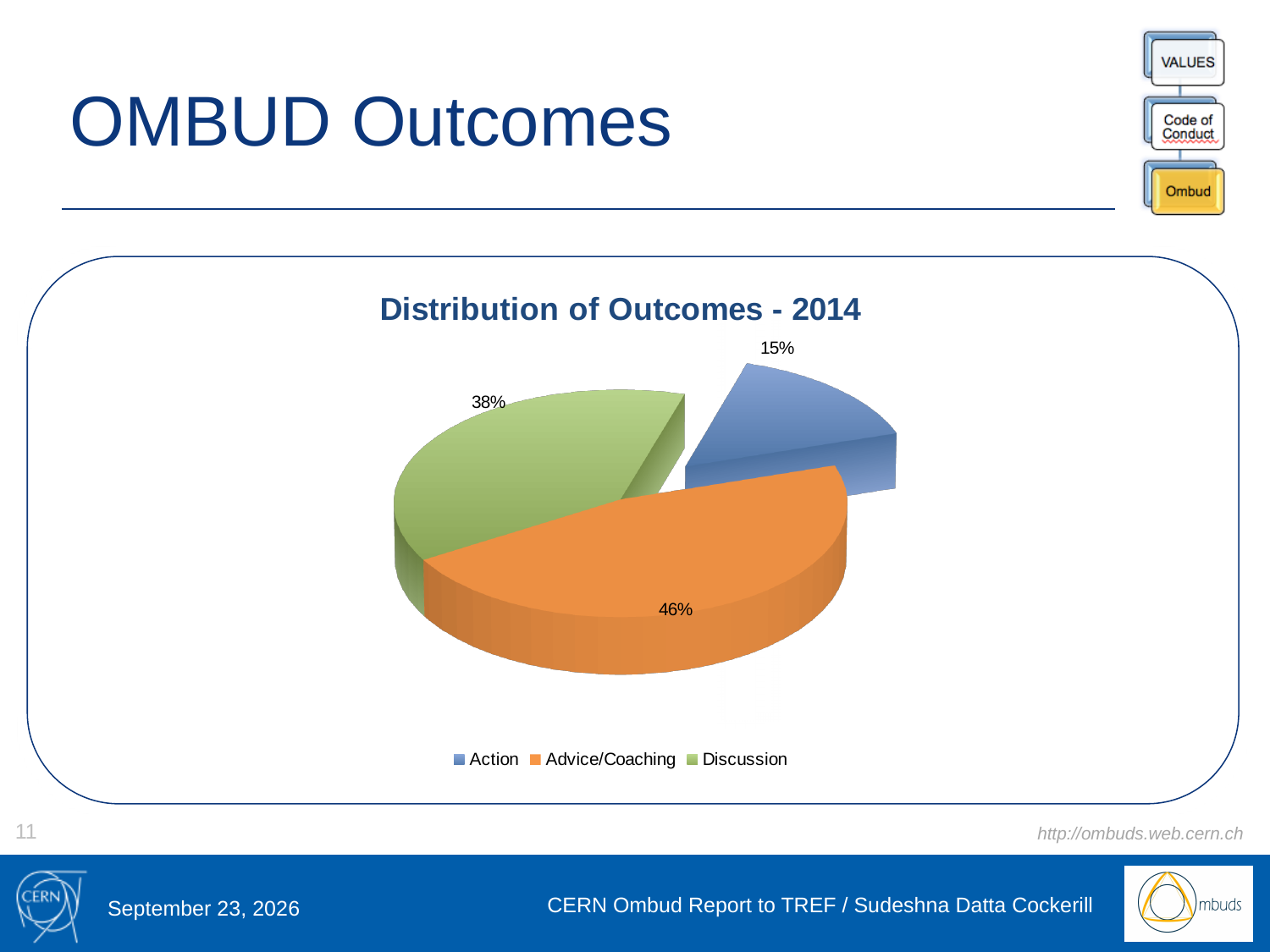
What type of chart is shown on the slide? Pie chart How many categories does the pie chart show? 3 Which outcome category has the largest share? Advice/Coaching What share of outcomes is Action? 15% What is the title of the chart? Distribution of Outcomes - 2014 How many entries does the legend list? 3 What share of outcomes is Advice/Coaching? 46% Which is larger, the share for Discussion or the share for Action? Discussion Which outcome category has the smallest share? Action What share of outcomes is Discussion? 38% What is the difference in percentage points between Advice/Coaching and Discussion? 8 Which colour represents Discussion in the pie chart? Green